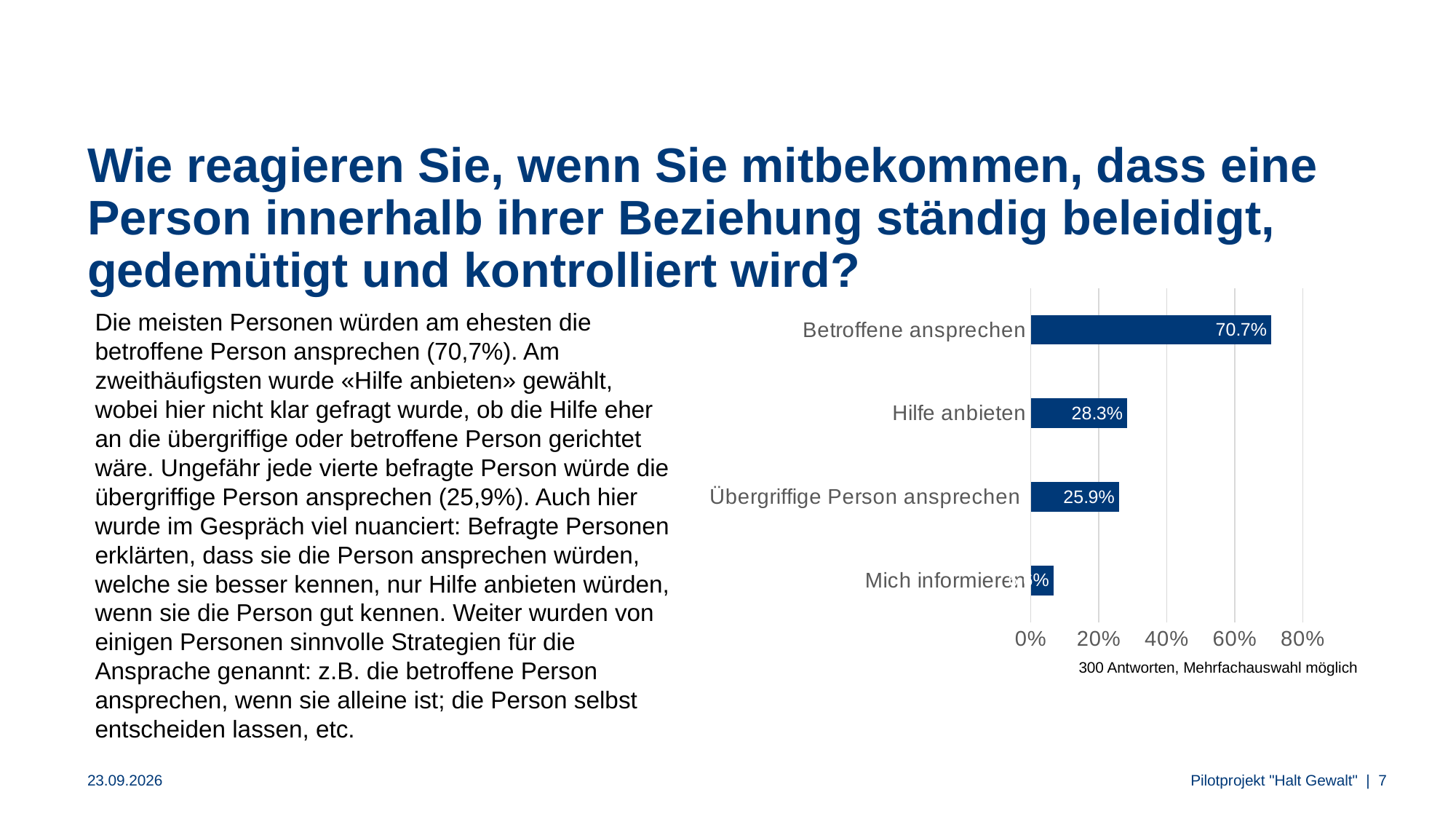
Which category has the lowest value? Mich informieren What is the value for "Betroffene ansprechen"? 70.7% What is the value for "Hilfe anbieten"? 28.3% What is the difference between the values for "Betroffene ansprechen" and "Hilfe anbieten"? 42.4 percentage points What is the value for "Übergriffige Person ansprechen"? 25.9% Which is larger, the value for "Hilfe anbieten" or for "Übergriffige Person ansprechen"? Hilfe anbieten What kind of chart is shown on the slide? bar chart Which category has the highest value? Betroffene ansprechen According to the note below the chart, how many responses does the chart represent? 300 Antworten How many categories are shown in the chart? 4 What is the difference between the values for "Hilfe anbieten" and "Übergriffige Person ansprechen"? 2.4 percentage points Is the value for "Mich informieren" greater or less than 20%? less